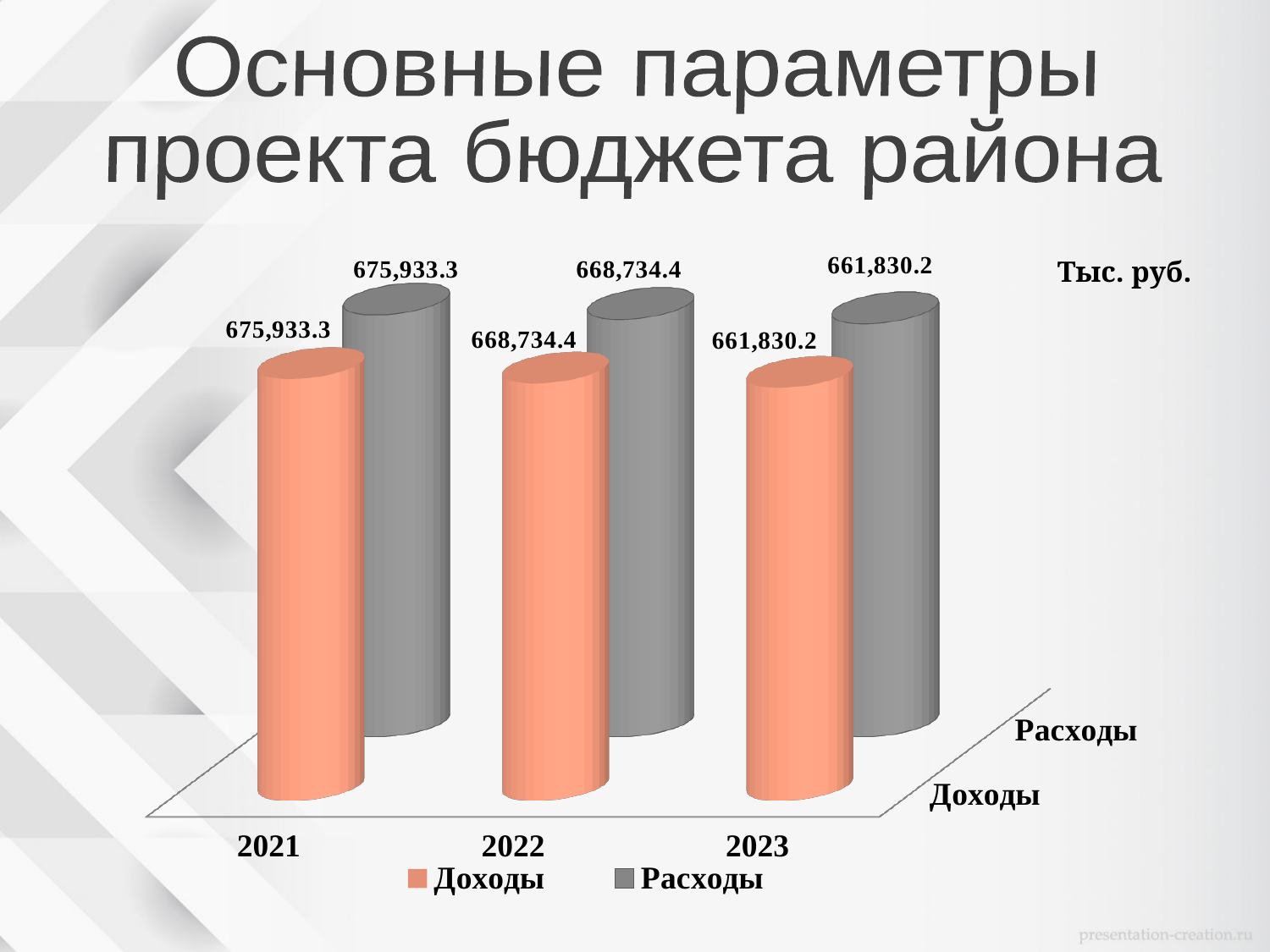
What is the value of Расходы for 2023? 661,830.2 What is the difference between Расходы in 2021 and Расходы in 2023? 14,103.1 What is the value of Расходы for 2022? 668,734.4 What is the difference between Доходы in 2021 and Доходы in 2022? 7,198.9 In which year is Доходы the highest? 2021 How many series does the legend list? 2 What is the value of Доходы for 2021? 675,933.3 In which year is Расходы the lowest? 2023 Which is larger: Доходы in 2022 or Доходы in 2023? Доходы in 2022 How many years are shown on the x axis? 3 Do the Доходы values rise or fall from 2021 to 2023? fall What is the value of Доходы for 2023? 661,830.2